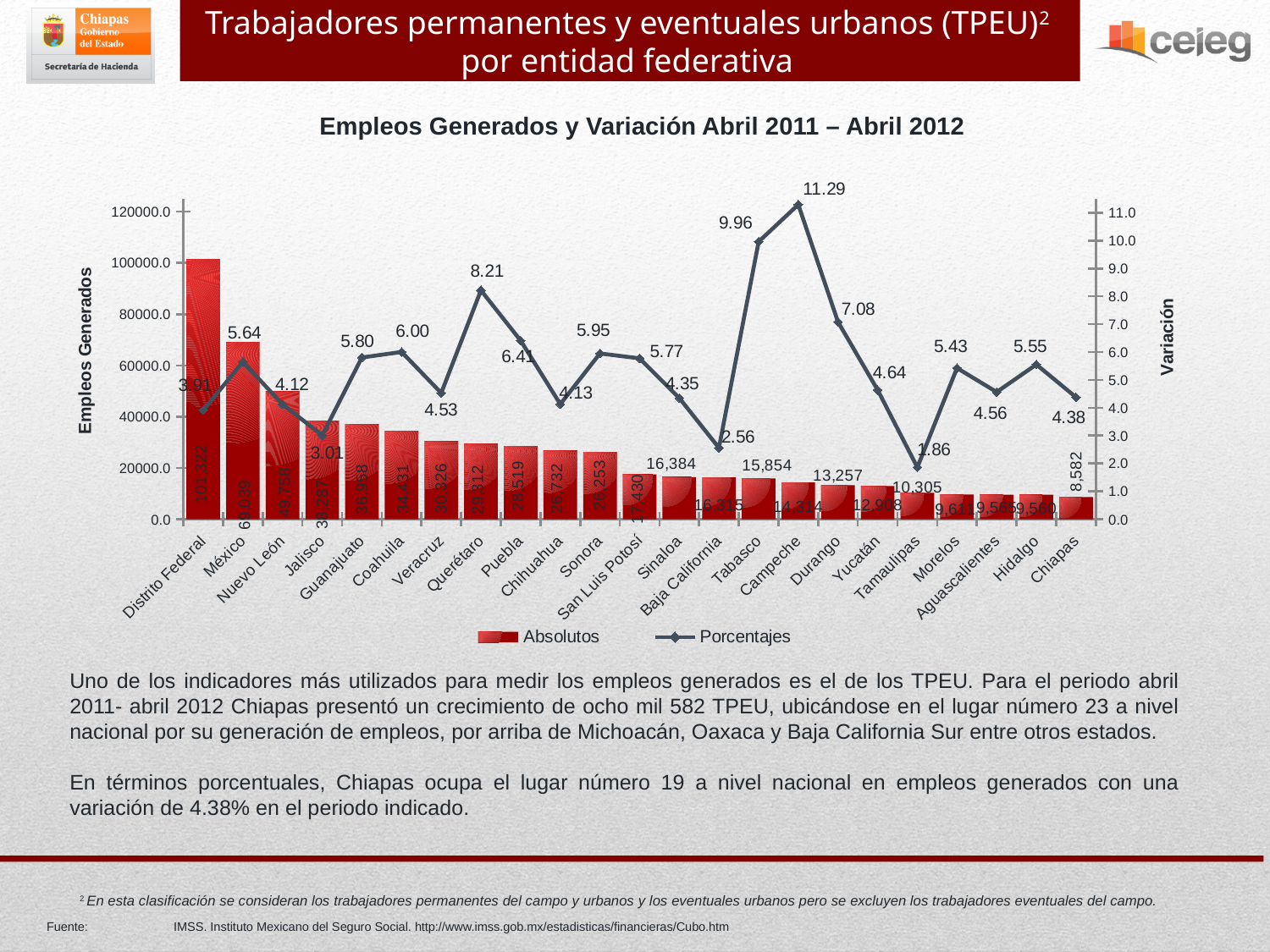
What is the Absolutos value for Chiapas? 8,582 What kind of chart is shown on the slide? A combined bar and line chart How many series does the legend list? 2 What are the two entries in the legend? Absolutos and Porcentajes What is the difference between the Porcentajes values of Campeche and Tabasco? 1.33 What is the Porcentajes value for Campeche? 11.29 Which entidad has the lowest Porcentajes value? Tamaulipas Which has the larger Porcentajes value, Tabasco or Campeche? Campeche Which entidad has the highest Absolutos value? Distrito Federal What is the Porcentajes value for Querétaro? 8.21 How many entidades federativas are shown on the x axis? 23 Which entidad has the highest Porcentajes value? Campeche